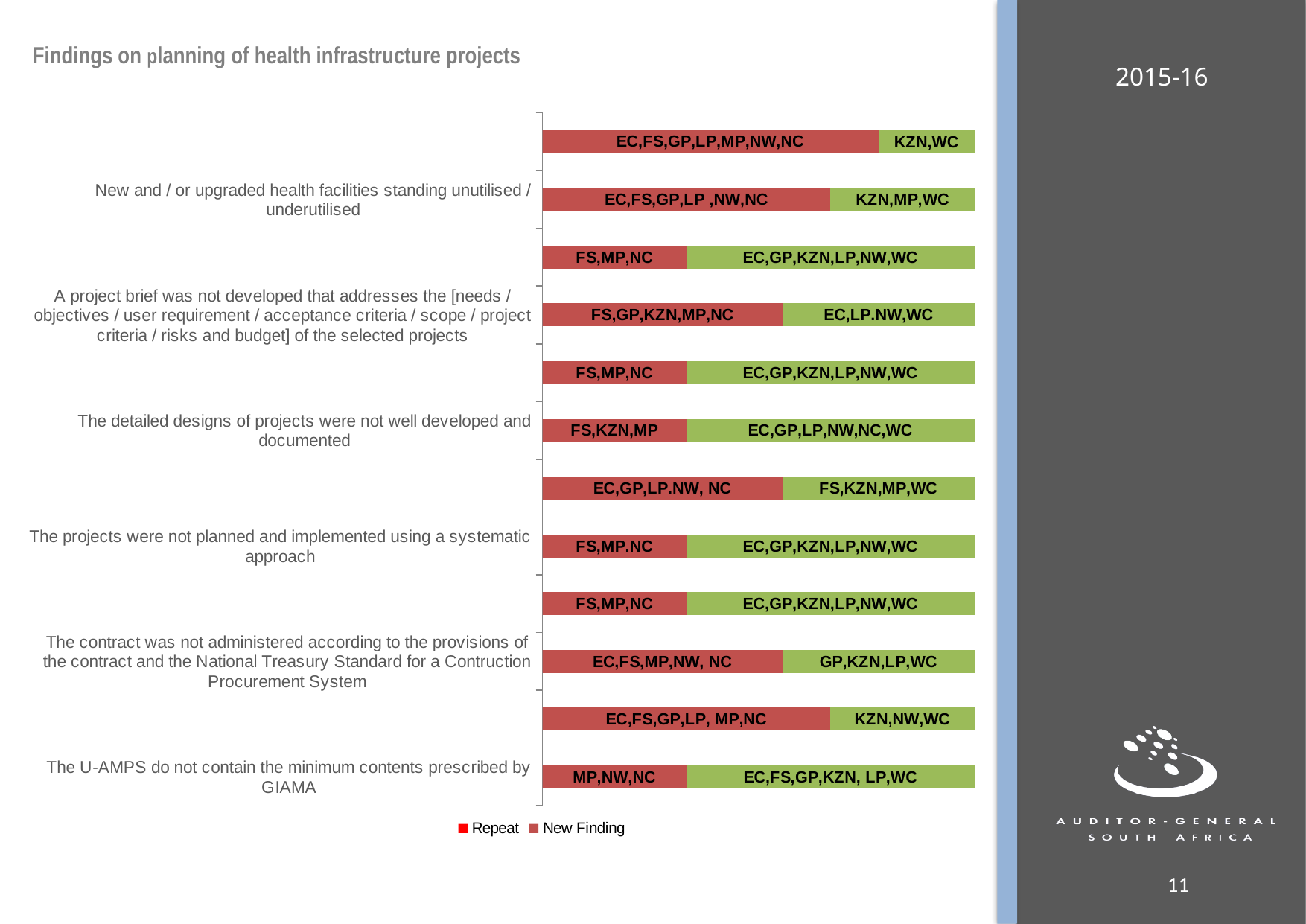
Which provinces are listed in the green segment of the bottom bar (aligned with 'The U-AMPS do not contain the minimum contents prescribed by GIAMA')? EC,FS,GP,KZN, LP,WC How many bars are plotted in the chart? 12 Which provinces are listed in the red segment of the bottom bar (aligned with 'The U-AMPS do not contain the minimum contents prescribed by GIAMA')? MP,NW,NC What kind of chart is shown on the slide? Stacked bar chart In the topmost bar, which segment is longer, the red one or the green one? Red How many series does the chart legend list? 2 Which provinces are listed in the green segment of the topmost bar? KZN,WC In the bottom bar, which segment is longer, the red one or the green one? Green Which provinces are listed in the red segment of the bar aligned with 'The detailed designs of projects were not well developed and documented'? FS,KZN,MP Which provinces are listed in the red segment of the topmost bar? EC,FS,GP,LP,MP,NW,NC How many finding descriptions are labelled on the vertical axis of the chart? 6 What are the two entries in the chart legend? Repeat and New Finding